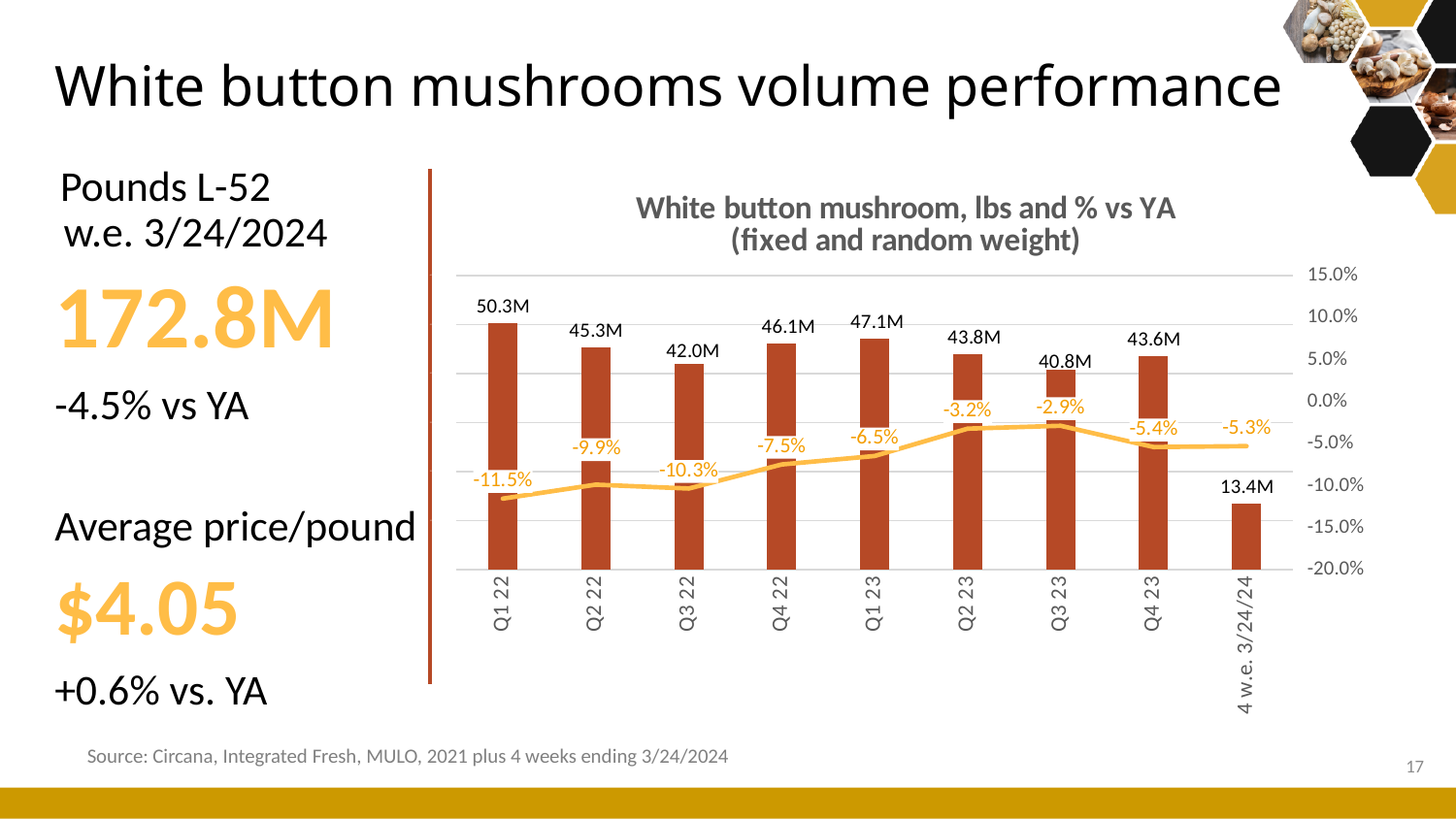
What is the lbs value for the 4 w.e. 3/24/24 period? 13.4M Does the % vs YA line generally rise or fall from Q1 22 to Q3 23? Rise Which quarter has the highest lbs value? Q1 22 Which category has the lowest lbs value? 4 w.e. 3/24/24 What kind of chart is this? Combined bar and line chart What is the % vs YA value for Q3 23? -2.9% How many categories are shown on the x axis? 9 What is the difference in lbs between Q1 23 and Q2 23? 3.3M Which quarter has the lowest % vs YA value? Q1 22 What is the title of the chart? White button mushroom, lbs and % vs YA (fixed and random weight) Which is larger, the lbs value for Q4 22 or Q4 23? Q4 22 What is the lbs value for Q1 22? 50.3M